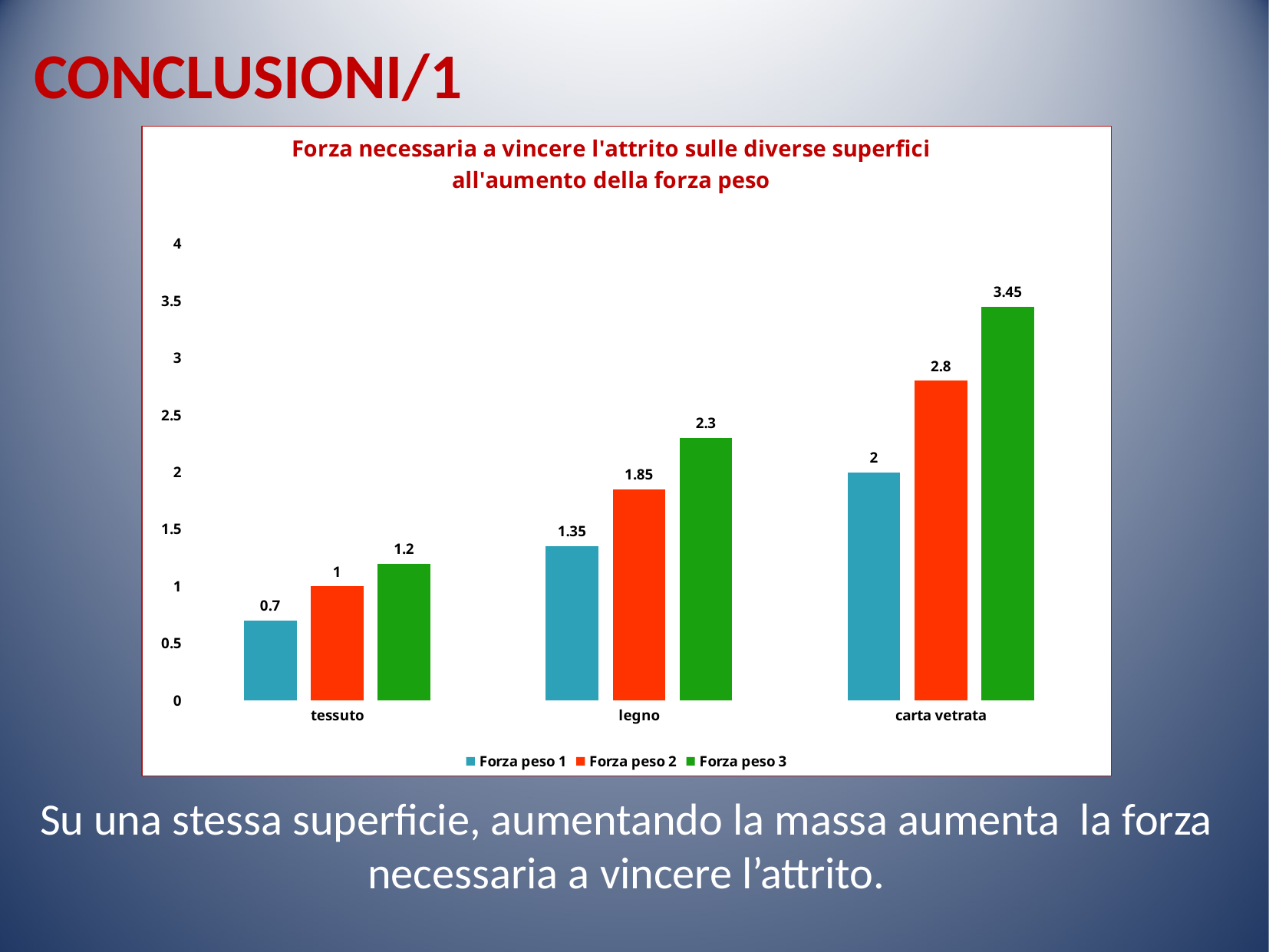
Do the values for Forza peso 2 rise or fall from tessuto to carta vetrata? rise What is the difference between Forza peso 3 and Forza peso 1 on carta vetrata? 1.45 What kind of chart is shown on the slide? bar chart What is the value for Forza peso 2 on legno? 1.85 Which surface has the lowest value for Forza peso 1? tessuto Which is larger: Forza peso 2 on carta vetrata or Forza peso 3 on legno? Forza peso 2 on carta vetrata Which surface has the highest value for Forza peso 3? carta vetrata How many series does the legend list? 3 What colour are the bars for Forza peso 3? green What is the value for Forza peso 3 on carta vetrata? 3.45 How many surface categories are shown on the x axis? 3 What is the value for Forza peso 1 on tessuto? 0.7